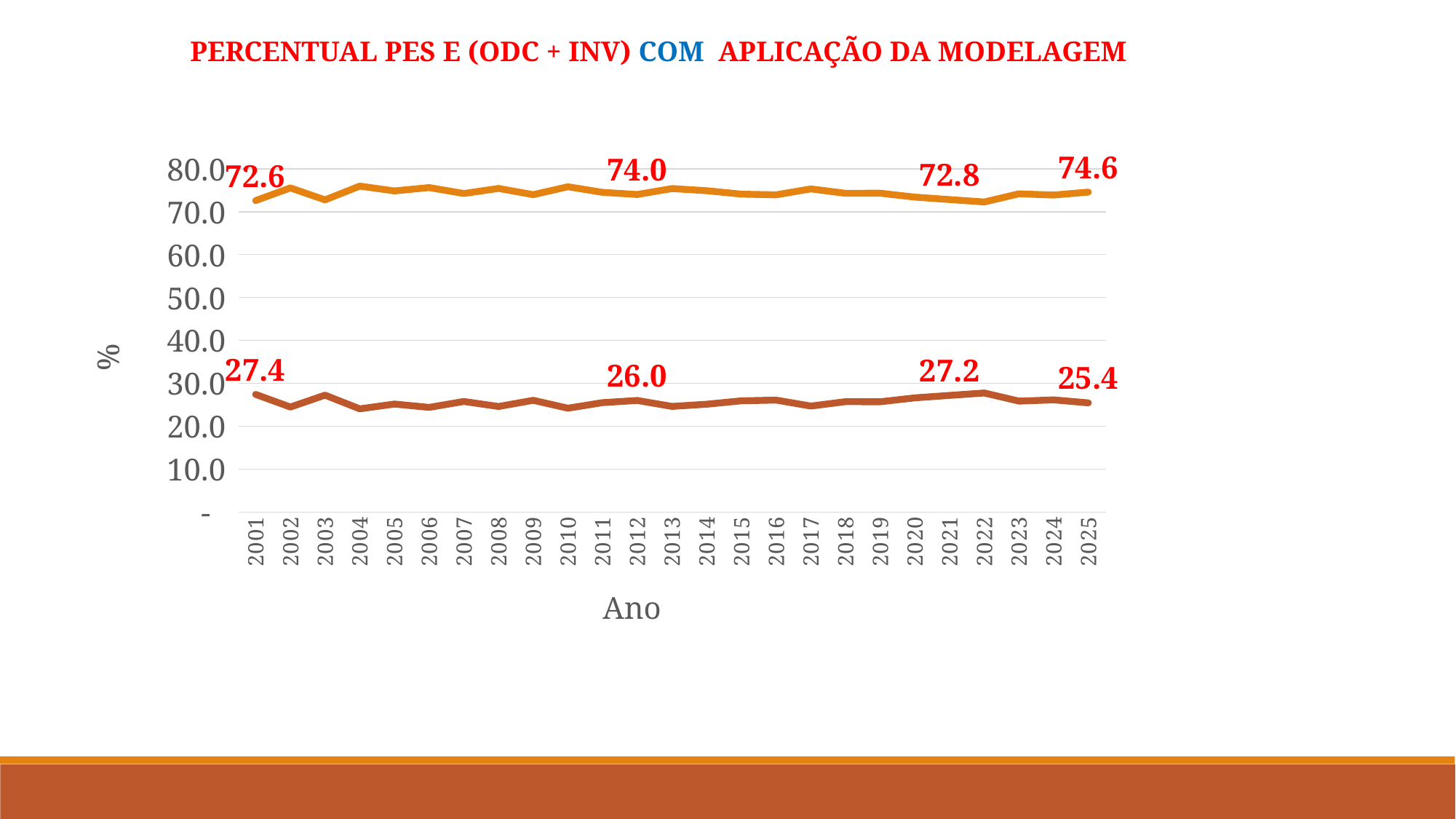
By how much does the upper (orange) line's labelled value in 2025 exceed its value in 2001? 2.0 In 2001, which line has the larger value, the upper (orange) line or the lower (brown) line? the upper (orange) line What is the title of the x axis? Ano Is the value of the lower (brown) line in 2004 greater or less than 30.0? less What is the labelled value of the upper (orange) line in 2001? 72.6 By how much is the lower (brown) line's labelled value in 2001 higher than its value in 2025? 2.0 What kind of chart is shown on the slide? line chart What is the labelled value of the upper (orange) line in 2025? 74.6 How many years are plotted along the x axis? 25 Is the value of the upper (orange) line in 2010 greater or less than 70.0? greater What is the labelled value of the lower (brown) line in 2001? 27.4 What is the labelled value of the lower (brown) line in 2025? 25.4